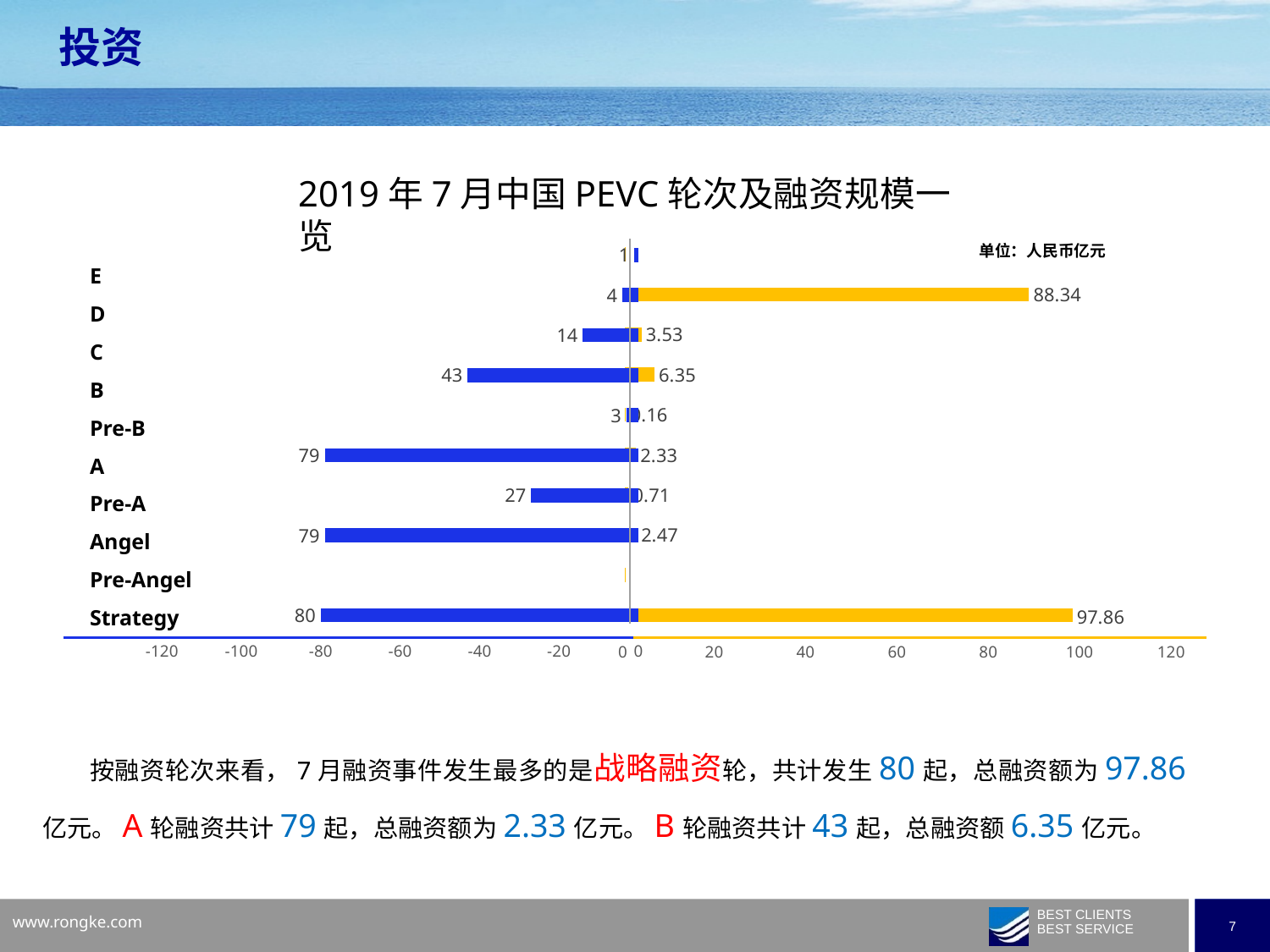
Which has more financing events, the Pre-A round or the C round? Pre-A What kind of chart is shown on the slide? Bar chart What is the difference in the number of financing events between the B round and the C round? 29 What is the financing amount for the C round? 3.53 What is the financing amount shown for the D round? 88.34 Which round has the highest number of financing events? Strategy What unit is stated for the financing amounts in the chart? 人民币亿元 What is the number of financing events for the Strategy round? 80 What is the difference in financing amount between the Strategy round and the D round? 9.52 Which round has the highest financing amount? Strategy How many financing events are shown for the B round? 43 What is the total financing amount for the Strategy round? 97.86